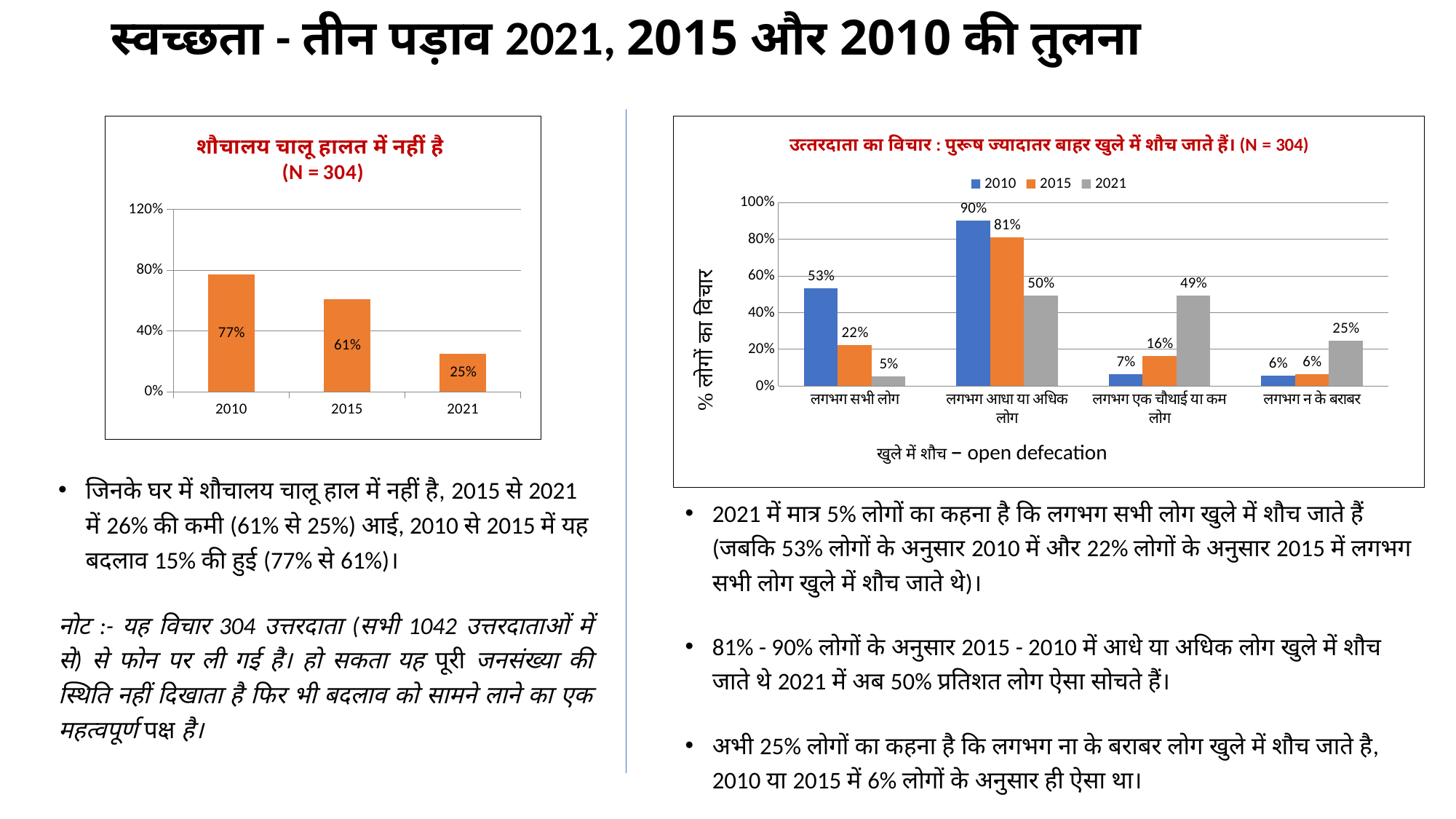
What kind of chart is the right chart (उत्तरदाता का विचार)? bar chart In the left chart (शौचालय चालू हालत में नहीं है), what is the value for 2021? 25% In the left chart (शौचालय चालू हालत में नहीं है), what is the difference between the 2015 and 2021 values? 36% In the left chart (शौचालय चालू हालत में नहीं है), do the values rise or fall from 2010 to 2021? fall In the left chart (शौचालय चालू हालत में नहीं है), how many years are plotted? 3 In the right chart (उत्तरदाता का विचार), what is the 2021 value for लगभग एक चौथाई या कम लोग? 49% In the right chart (उत्तरदाता का विचार), what is the 2010 value for लगभग आधा या अधिक लोग? 90% In the right chart (उत्तरदाता का विचार), what is the difference between the 2010 and 2021 values for लगभग सभी लोग? 48% In the right chart (उत्तरदाता का विचार), how many series does the legend list? 3 In the left chart (शौचालय चालू हालत में नहीं है), what is the value for 2010? 77% In the right chart (उत्तरदाता का विचार), which category has the highest 2021 value? लगभग आधा या अधिक लोग In the left chart (शौचालय चालू हालत में नहीं है), which year has the lowest value? 2021